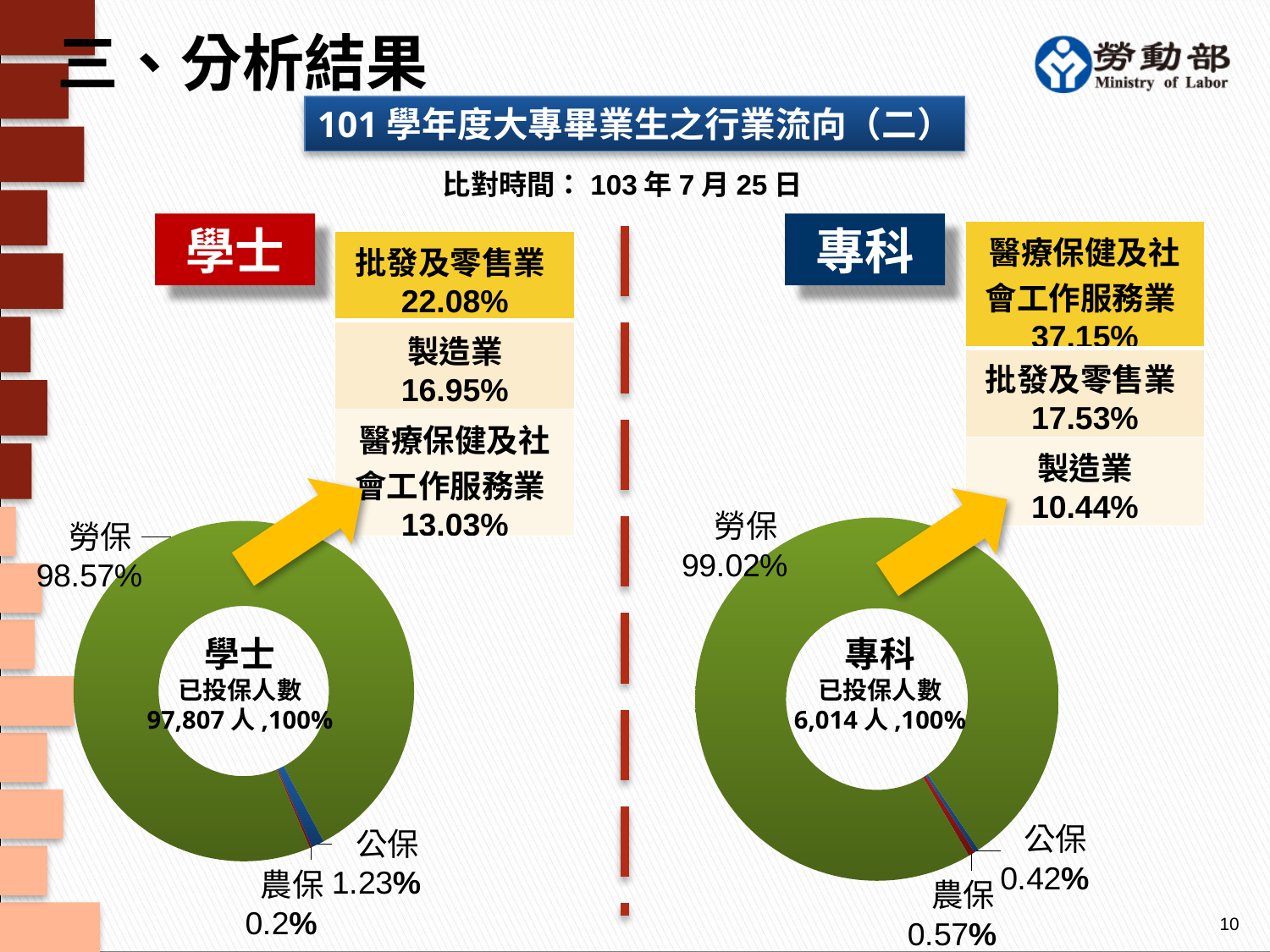
In the 專科 donut chart on the right, what is the value for 勞保? 99.02% What is the total insured number (已投保人數) shown in the centre of the 學士 chart? 97,807 人 In the 學士 donut chart on the left, what is the value for 勞保? 98.57% In the 專科 donut chart on the right, which category has the largest share? 勞保 What is the difference between the 勞保 share in the 專科 chart and the 勞保 share in the 學士 chart? 0.45% In the 學士 donut chart on the left, which category has the smallest share? 農保 In the 專科 donut chart on the right, which is larger, 公保 or 農保? 農保 In the 專科 donut chart on the right, what is the value for 農保? 0.57% In the 學士 donut chart on the left, what is the value for 公保? 1.23% How many categories are shown in the 學士 donut chart on the left? 3 What is the total insured number (已投保人數) shown in the centre of the 專科 chart? 6,014 人 What type of chart is used for 學士 on the left? Donut (pie) chart